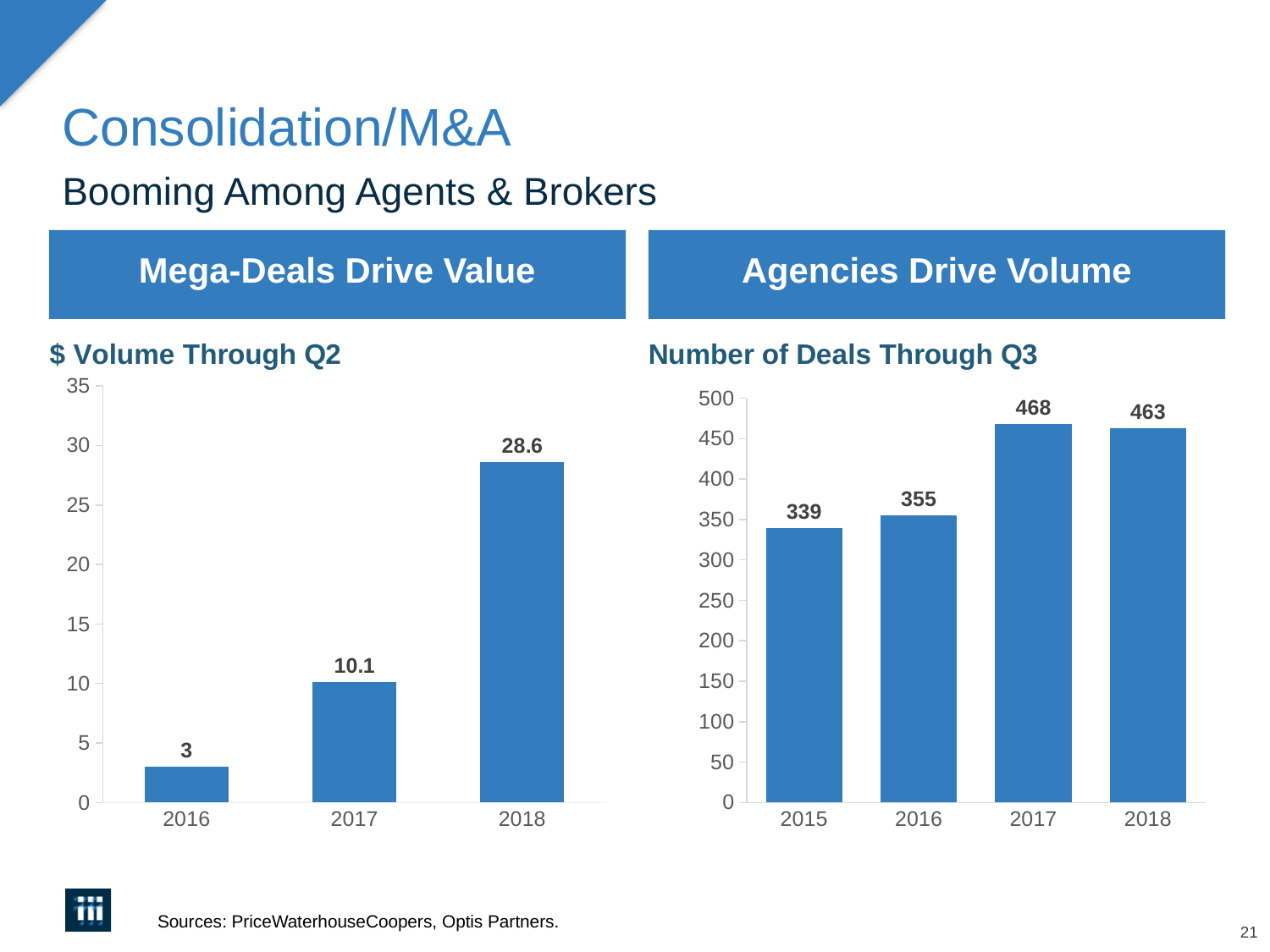
What kind of chart is the "$ Volume Through Q2" chart? Bar chart In the "$ Volume Through Q2" chart, what is the difference between the 2018 and 2017 values? 18.5 In the "$ Volume Through Q2" chart, what is the value for 2016? 3 In the "Number of Deals Through Q3" chart, is the value for 2015 greater or less than 300? greater In the "$ Volume Through Q2" chart, do the values rise or fall from 2016 to 2018? Rise In the "Number of Deals Through Q3" chart, which year has the lowest value? 2015 How many years are shown in the "Number of Deals Through Q3" chart? 4 In the "Number of Deals Through Q3" chart, what is the value for 2016? 355 In the "Number of Deals Through Q3" chart, what is the difference between the 2017 and 2018 values? 5 In the "Number of Deals Through Q3" chart, which year has the highest value? 2017 In the "$ Volume Through Q2" chart, which is larger, the value for 2017 or the value for 2016? 2017 In the "$ Volume Through Q2" chart, what is the value for 2018? 28.6